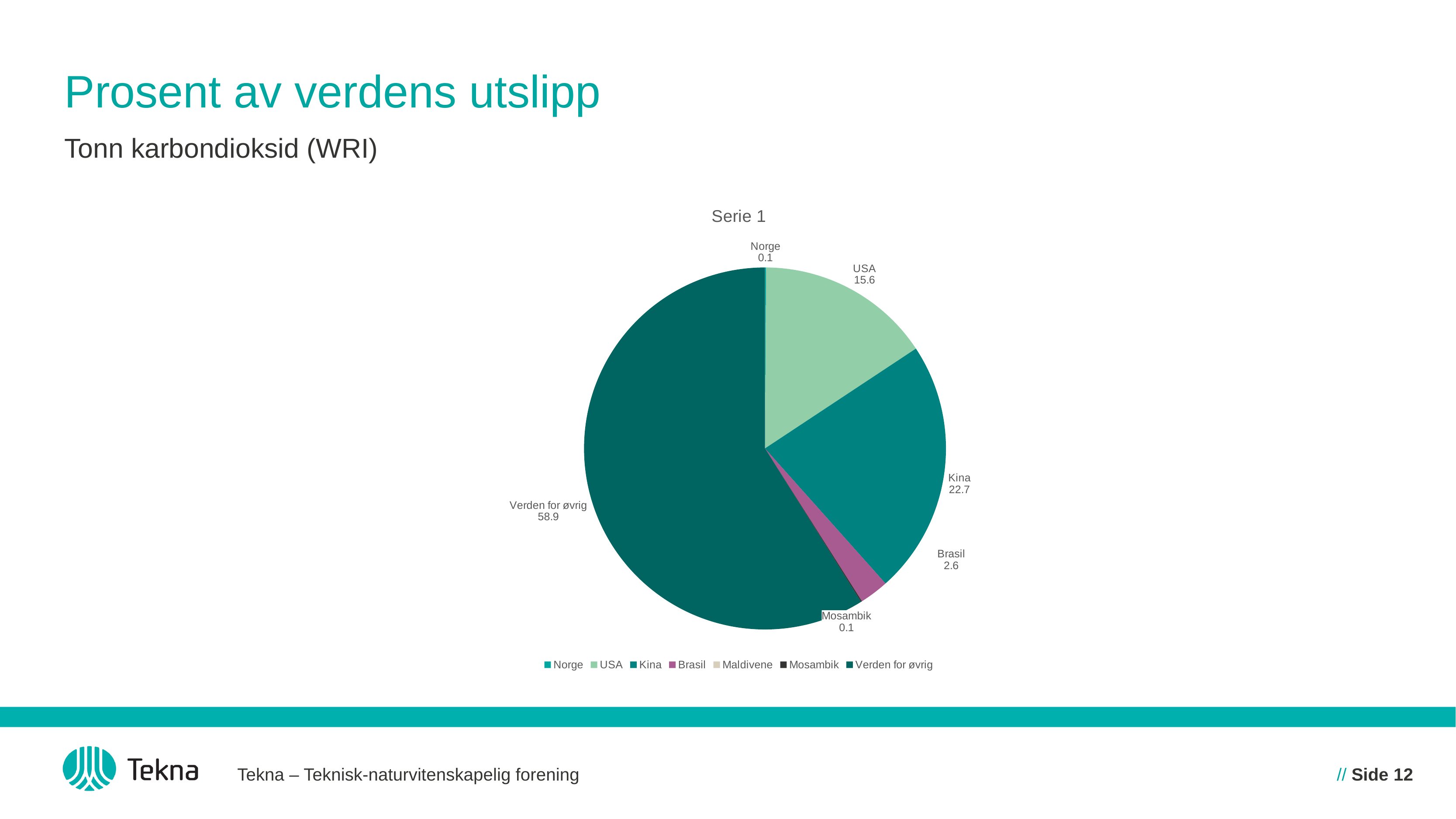
What is the value for Brasil in the pie chart? 2.6 What is the difference between the values for Kina and USA? 7.1 What kind of chart is shown on the slide? pie chart How many categories does the legend of the pie chart list? 7 Which category has the largest slice in the pie chart? Verden for øvrig What is the value for Kina in the pie chart? 22.7 What is the difference between the values for Brasil and Mosambik? 2.5 What is the title shown above the pie chart? Serie 1 What is the value for Verden for øvrig in the pie chart? 58.9 What is the value for USA in the pie chart? 15.6 What is the value for Norge in the pie chart? 0.1 Which is larger, the value for Kina or the value for USA? Kina